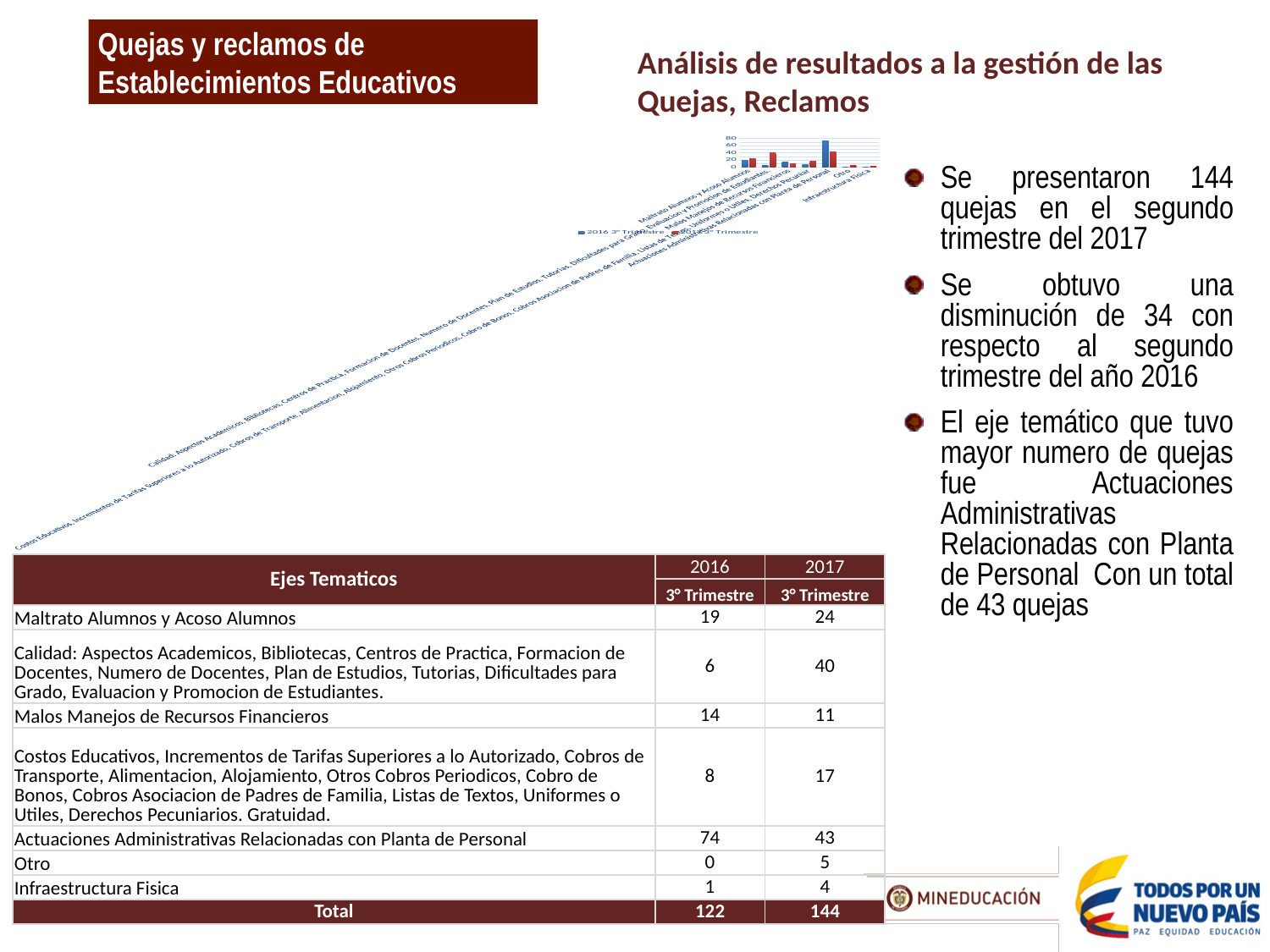
Which category has the lowest 2016 3° Trimestre value? Otro How many series does the chart's legend list? 2 Which is larger for the Calidad category: the 2016 3° Trimestre value or the 2017 3° Trimestre value? 2017 3° Trimestre What is the 2016 3° Trimestre value for Actuaciones Administrativas Relacionadas con Planta de Personal? 74 How many categories (ejes temáticos) are plotted in the chart? 7 What is the 2017 3° Trimestre value for Maltrato Alumnos y Acoso Alumnos? 24 Is the tallest bar in the chart greater or less than 60? greater What is the total number of quejas for 2017 3° Trimestre? 144 What kind of chart is shown on the slide? bar chart What is the 2017 3° Trimestre value for Actuaciones Administrativas Relacionadas con Planta de Personal? 43 Which category has the tallest bar in the chart? Actuaciones Administrativas Relacionadas con Planta de Personal What is the difference between the 2016 and 2017 values for Actuaciones Administrativas Relacionadas con Planta de Personal? 31